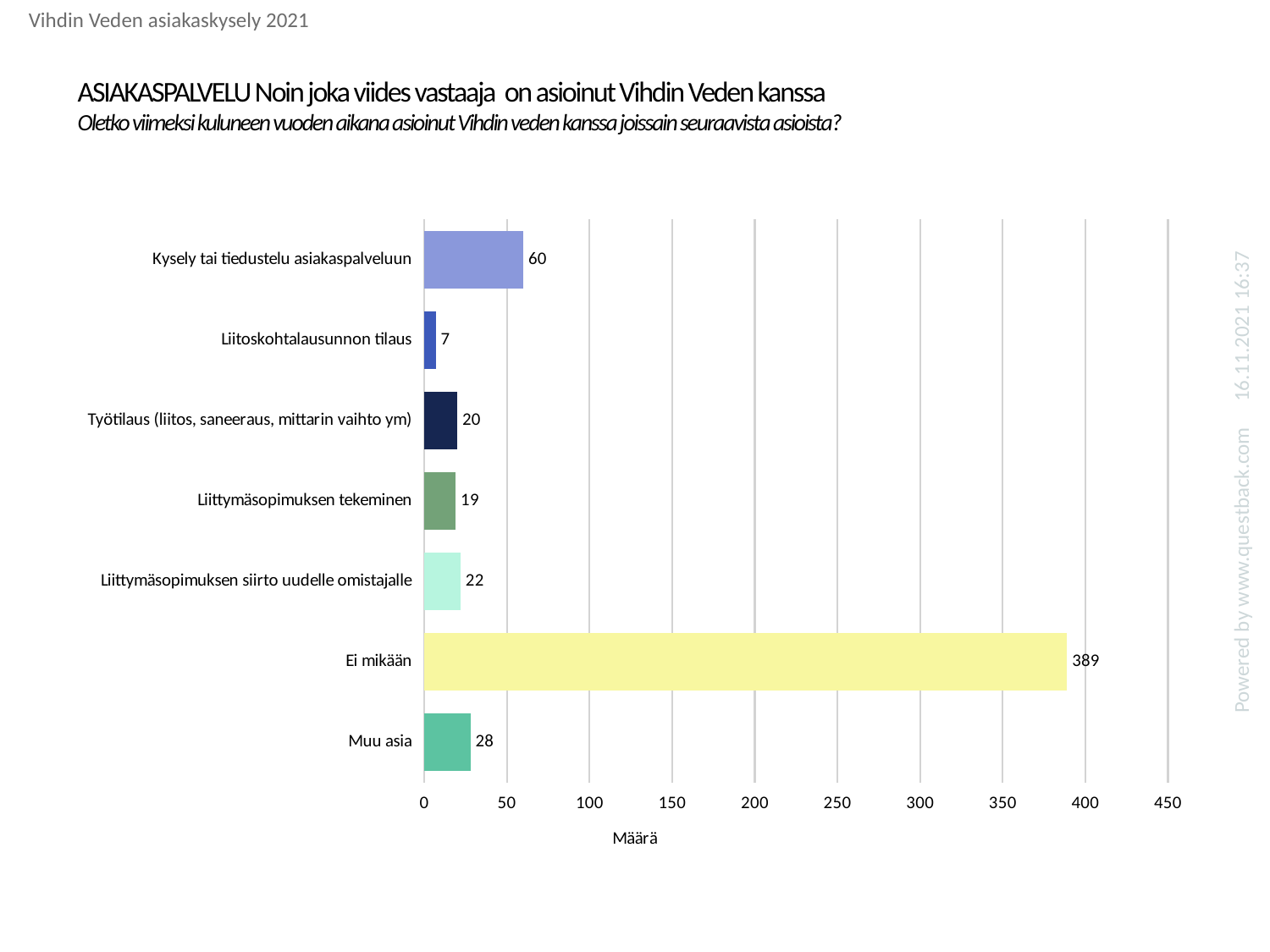
What is the difference between the values for "Muu asia" and "Työtilaus (liitos, saneeraus, mittarin vaihto ym)"? 8 Which is larger, the value for "Muu asia" or the value for "Liittymäsopimuksen tekeminen"? Muu asia Which category has the lowest value? Liitoskohtalausunnon tilaus Is the value for "Ei mikään" greater or less than 350? greater What is the difference between the values for "Ei mikään" and "Kysely tai tiedustelu asiakaspalveluun"? 329 What kind of chart is shown on the slide? bar chart How many categories are shown in the chart? 7 What is the value for "Kysely tai tiedustelu asiakaspalveluun"? 60 What is the label of the horizontal axis? Määrä What is the value for "Liittymäsopimuksen siirto uudelle omistajalle"? 22 What is the value for "Ei mikään"? 389 Which category has the highest value? Ei mikään